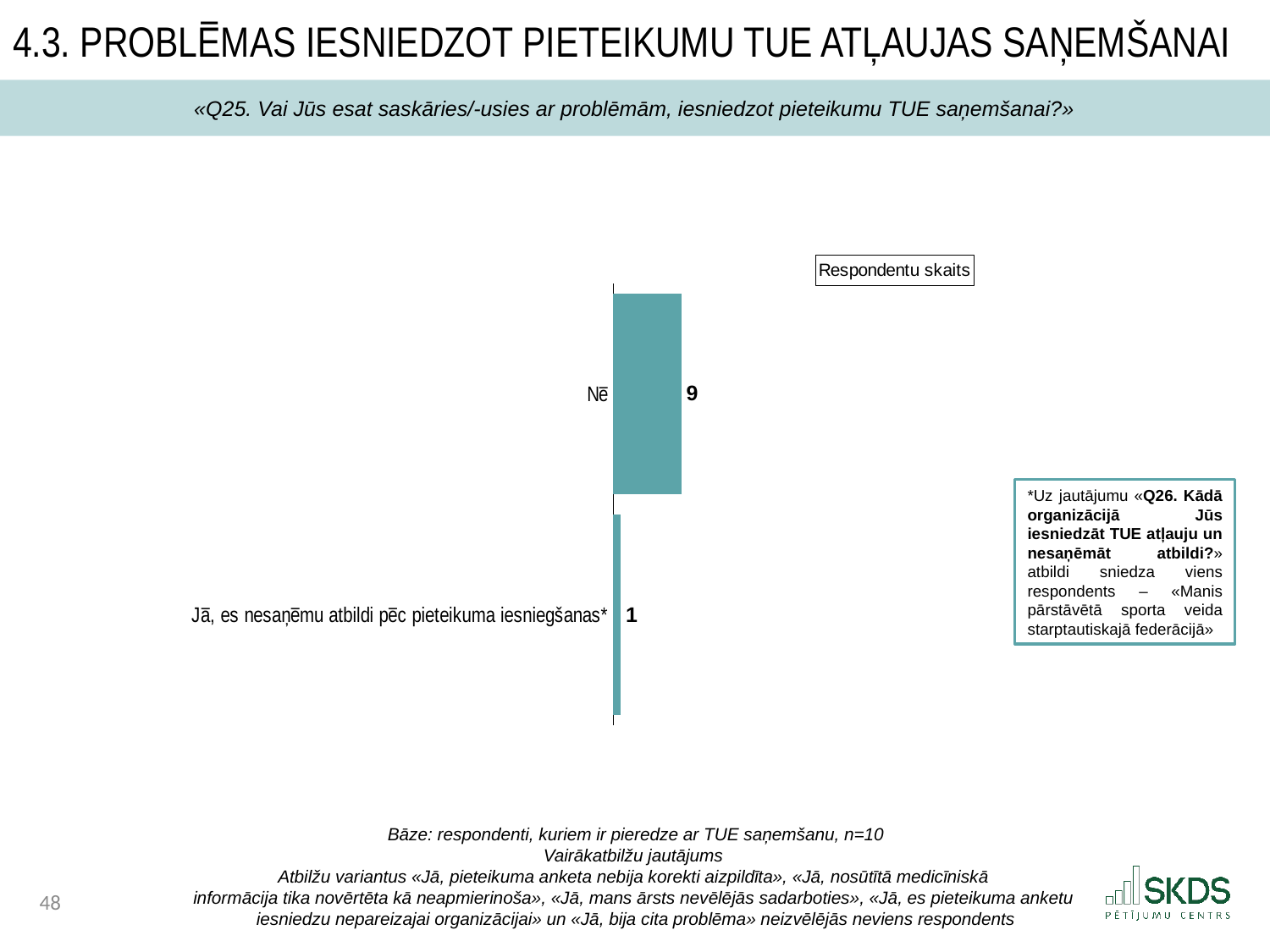
What kind of chart is shown on the slide? Bar chart What does the label above the chart say the values represent? Respondentu skaits How many categories are shown in the chart? 2 What is the value for "Nē"? 9 What is the difference between the value for "Nē" and the value for "Jā, es nesaņēmu atbildi pēc pieteikuma iesniegšanas*"? 8 What is the value for "Jā, es nesaņēmu atbildi pēc pieteikuma iesniegšanas*"? 1 What colour are the bars in the chart? Teal What is the total of the two values shown in the chart? 10 Which is larger: the value for "Nē" or the value for "Jā, es nesaņēmu atbildi pēc pieteikuma iesniegšanas*"? Nē Which category has the lowest value? Jā, es nesaņēmu atbildi pēc pieteikuma iesniegšanas* Which category has the highest value? Nē